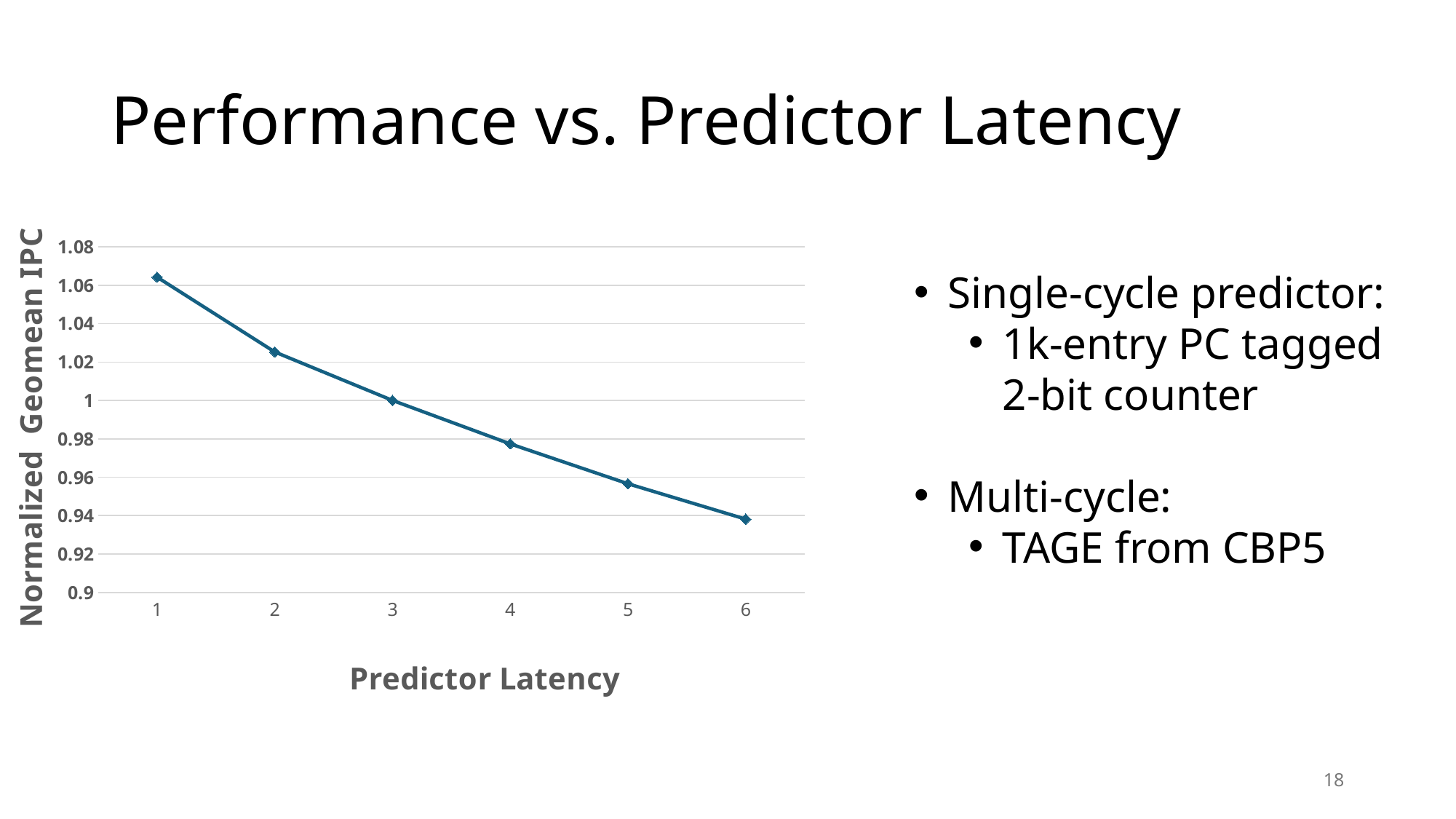
Is the Normalized Geomean IPC at a Predictor Latency of 6 greater or less than 0.96? less At which Predictor Latency is the Normalized Geomean IPC lowest? 6 What is the label of the x axis? Predictor Latency Is the Normalized Geomean IPC at a Predictor Latency of 4 greater or less than 1? less How many data points are plotted on the line? 6 Which has a higher Normalized Geomean IPC: a Predictor Latency of 2 or a Predictor Latency of 5? 2 At which Predictor Latency is the Normalized Geomean IPC highest? 1 What kind of chart is shown on the slide? line chart What is the Normalized Geomean IPC at a Predictor Latency of 3? 1 Is the Normalized Geomean IPC at a Predictor Latency of 1 greater or less than 1.04? greater What is the label of the y axis? Normalized Geomean IPC Does the Normalized Geomean IPC rise or fall as Predictor Latency increases? fall